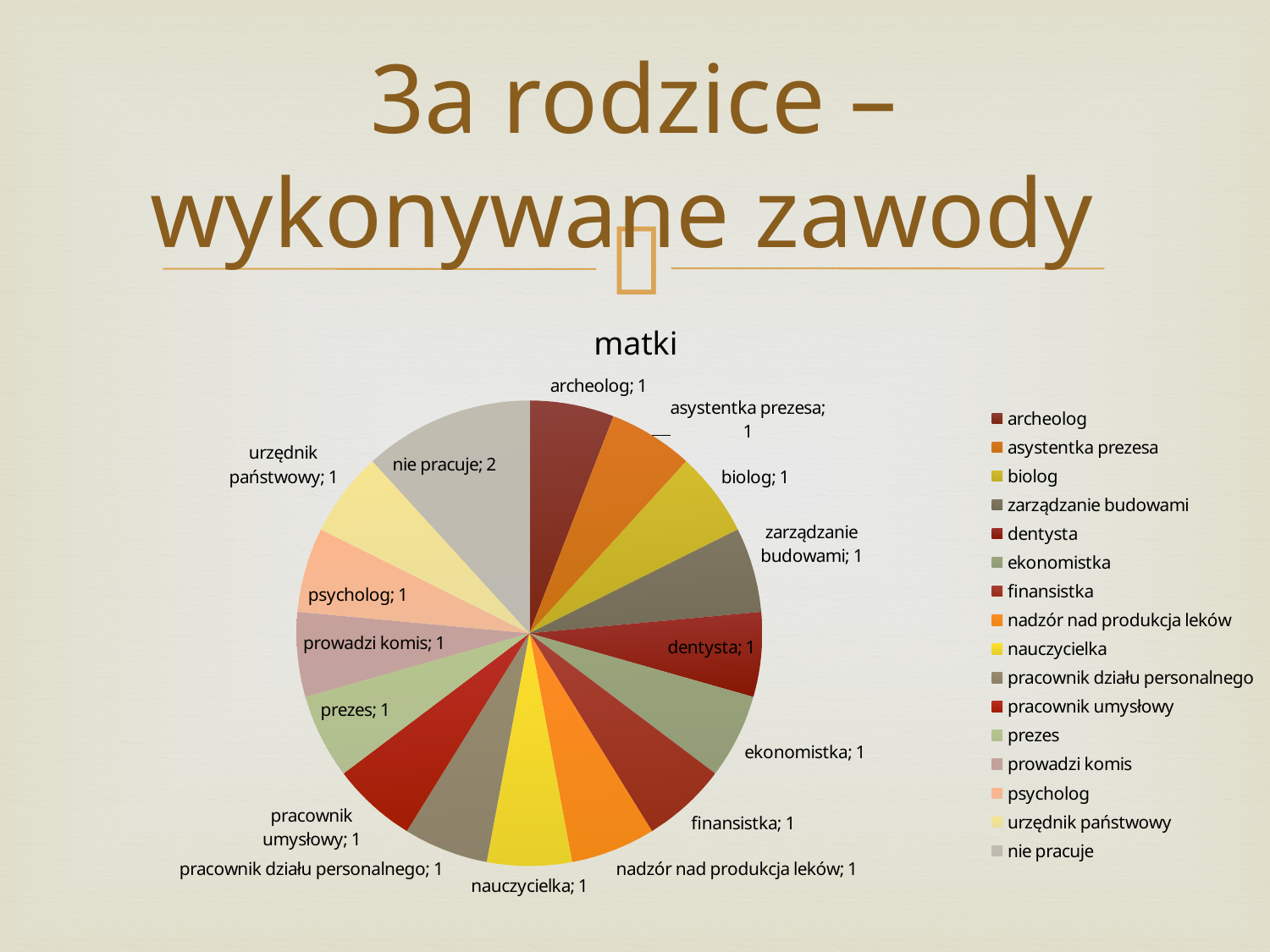
How many categories (slices) does the pie chart have? 16 What is the value for "urzędnik państwowy"? 1 What kind of chart is shown on the slide? pie chart How many entries does the legend list? 16 What is the title of the chart? matki What is the value for "nie pracuje"? 2 What is the total of all the values in the pie chart? 17 Which category has the highest value? nie pracuje Which is larger, the value for "nie pracuje" or the value for "psycholog"? nie pracuje What is the value for "dentysta"? 1 What is the difference between the value for "nie pracuje" and the value for "archeolog"? 1 What is the value for "nauczycielka"? 1